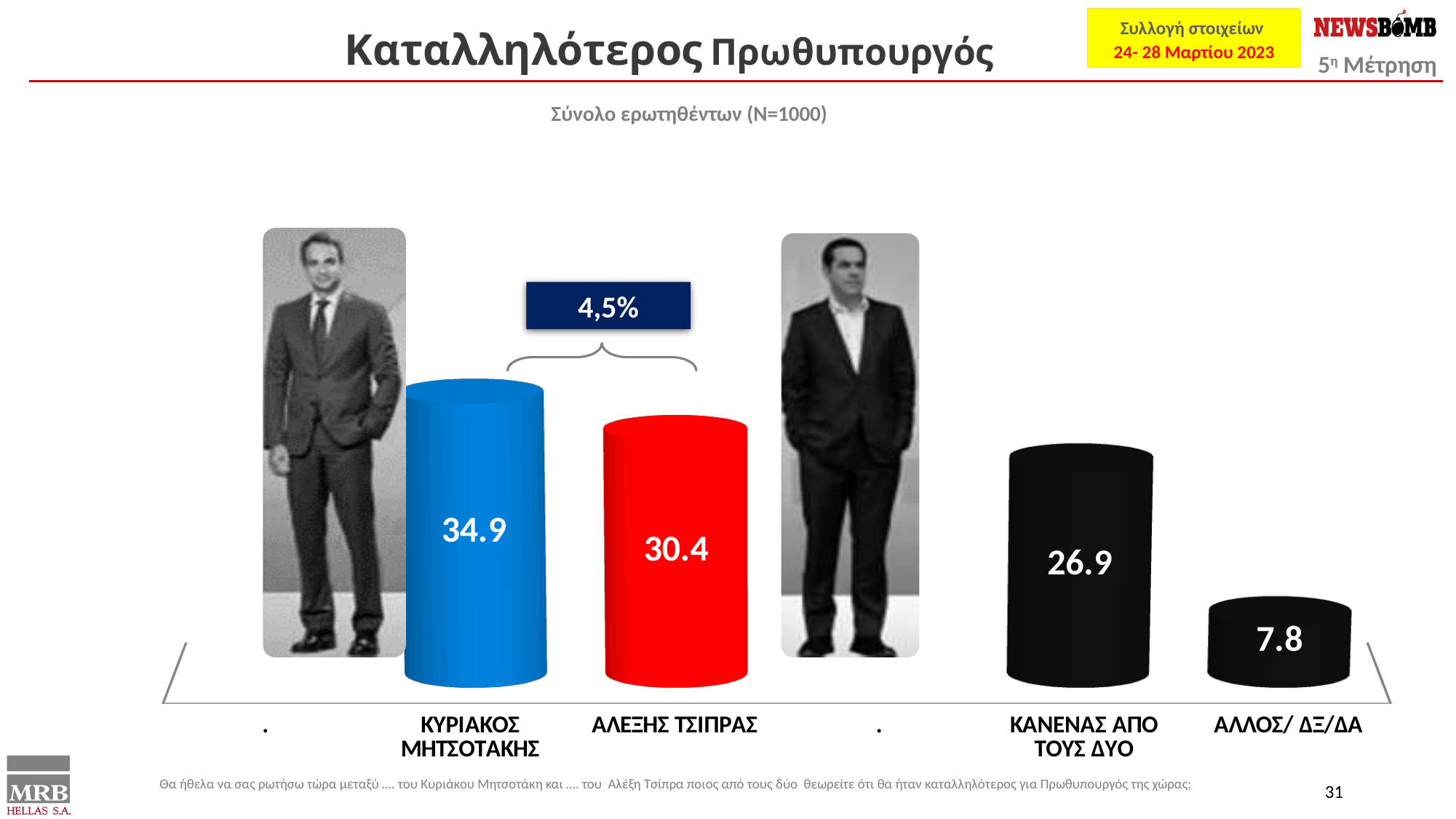
What kind of chart is shown on the slide? Bar chart Which category has the lowest value? ΑΛΛΟΣ/ ΔΞ/ΔΑ What is the difference between the values for ΚΑΝΕΝΑΣ ΑΠΟ ΤΟΥΣ ΔΥΟ and ΑΛΛΟΣ/ ΔΞ/ΔΑ? 19.1 What value is shown for ΑΛΛΟΣ/ ΔΞ/ΔΑ? 7.8 What is the title of the chart on the slide? Καταλληλότερος Πρωθυπουργός Which category has the highest value? ΚΥΡΙΑΚΟΣ ΜΗΤΣΟΤΑΚΗΣ What value is shown for ΚΑΝΕΝΑΣ ΑΠΟ ΤΟΥΣ ΔΥΟ? 26.9 What value is shown for ΚΥΡΙΑΚΟΣ ΜΗΤΣΟΤΑΚΗΣ? 34.9 What value is shown for ΑΛΕΞΗΣ ΤΣΙΠΡΑΣ? 30.4 Which is larger, the value for ΑΛΕΞΗΣ ΤΣΙΠΡΑΣ or the value for ΚΑΝΕΝΑΣ ΑΠΟ ΤΟΥΣ ΔΥΟ? ΑΛΕΞΗΣ ΤΣΙΠΡΑΣ How many labelled bars does the chart show? 4 What is the difference between the values for ΚΥΡΙΑΚΟΣ ΜΗΤΣΟΤΑΚΗΣ and ΑΛΕΞΗΣ ΤΣΙΠΡΑΣ, as labelled on the slide? 4,5%